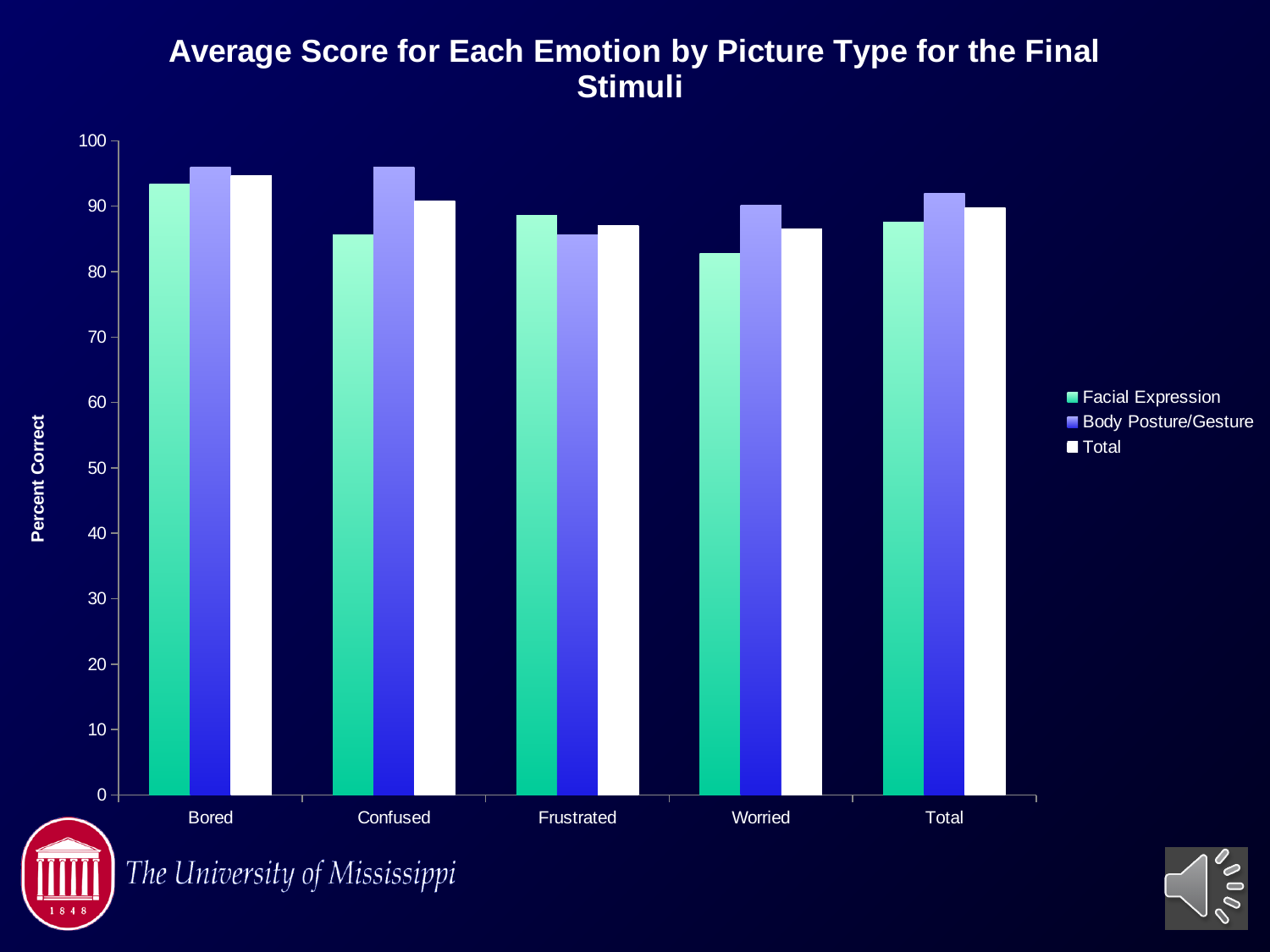
For which emotion is the Body Posture/Gesture score lowest? Frustrated How many emotion categories are shown on the x axis? 5 Is the Facial Expression value for Worried greater or less than 90? less For Confused, which is larger: the Facial Expression score or the Body Posture/Gesture score? Body Posture/Gesture What is the label on the vertical axis? Percent Correct For which emotion is the Facial Expression score lowest? Worried Which series is shown in white in the legend? Total For which emotion is the Facial Expression score highest? Bored What kind of chart is shown on the slide? bar chart Is the Body Posture/Gesture value for Bored greater or less than 90? greater For Frustrated, which is larger: the Facial Expression score or the Body Posture/Gesture score? Facial Expression How many series does the legend list? 3